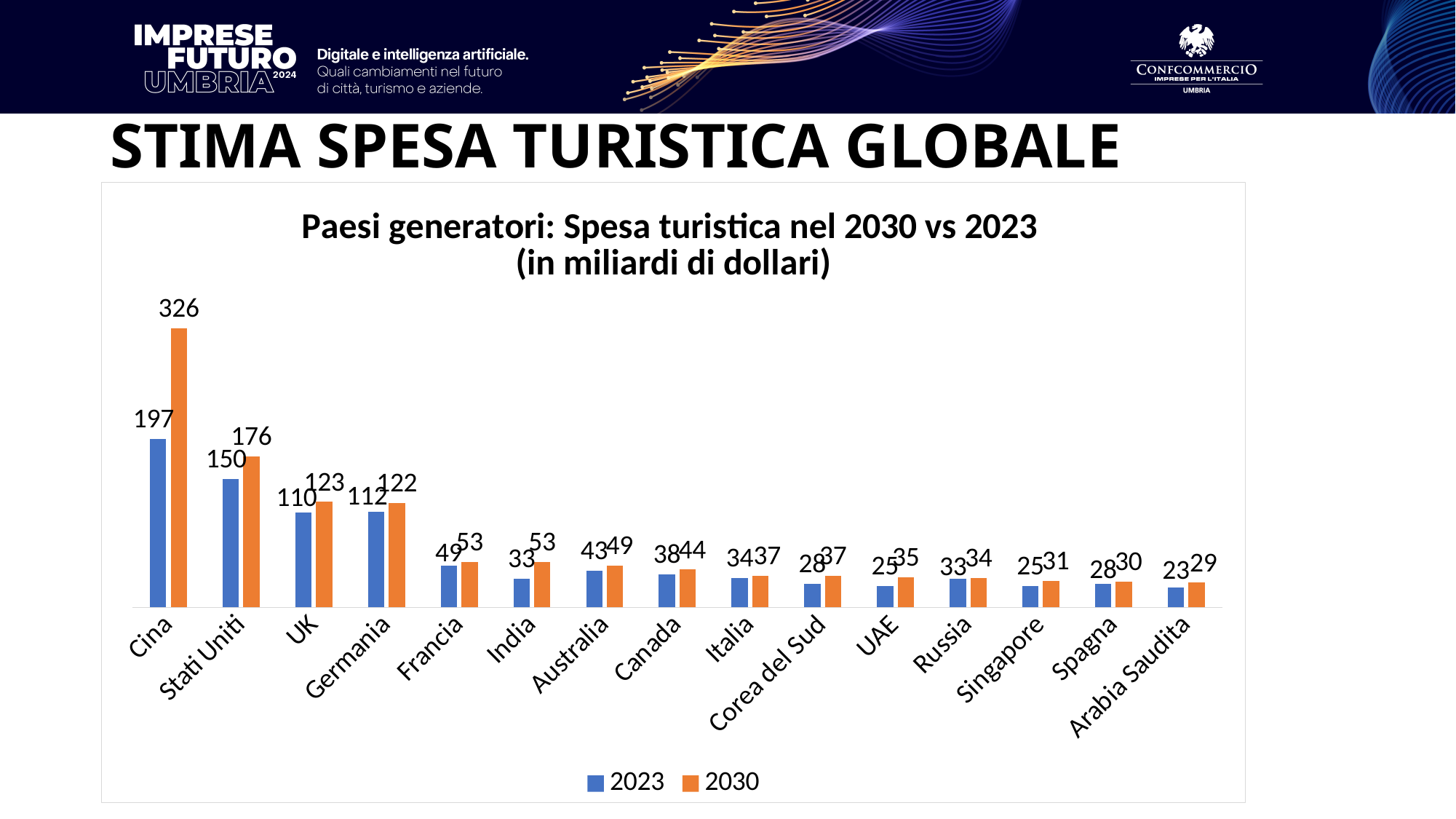
How many countries are shown on the x axis? 15 What kind of chart is shown on the slide? Bar chart Which is larger, the 2023 value for Germania or the 2023 value for UK? Germania What is the 2030 value for Cina? 326 Which country has the highest 2030 value? Cina What is the 2030 value for India? 53 What is the difference between the 2030 and 2023 values for Cina? 129 How many series does the legend list? 2 Which country has the lowest 2023 value? Arabia Saudita What is the difference between the 2030 values for Stati Uniti and UK? 53 What is the 2023 value for Italia? 34 What is the 2023 value for Stati Uniti? 150